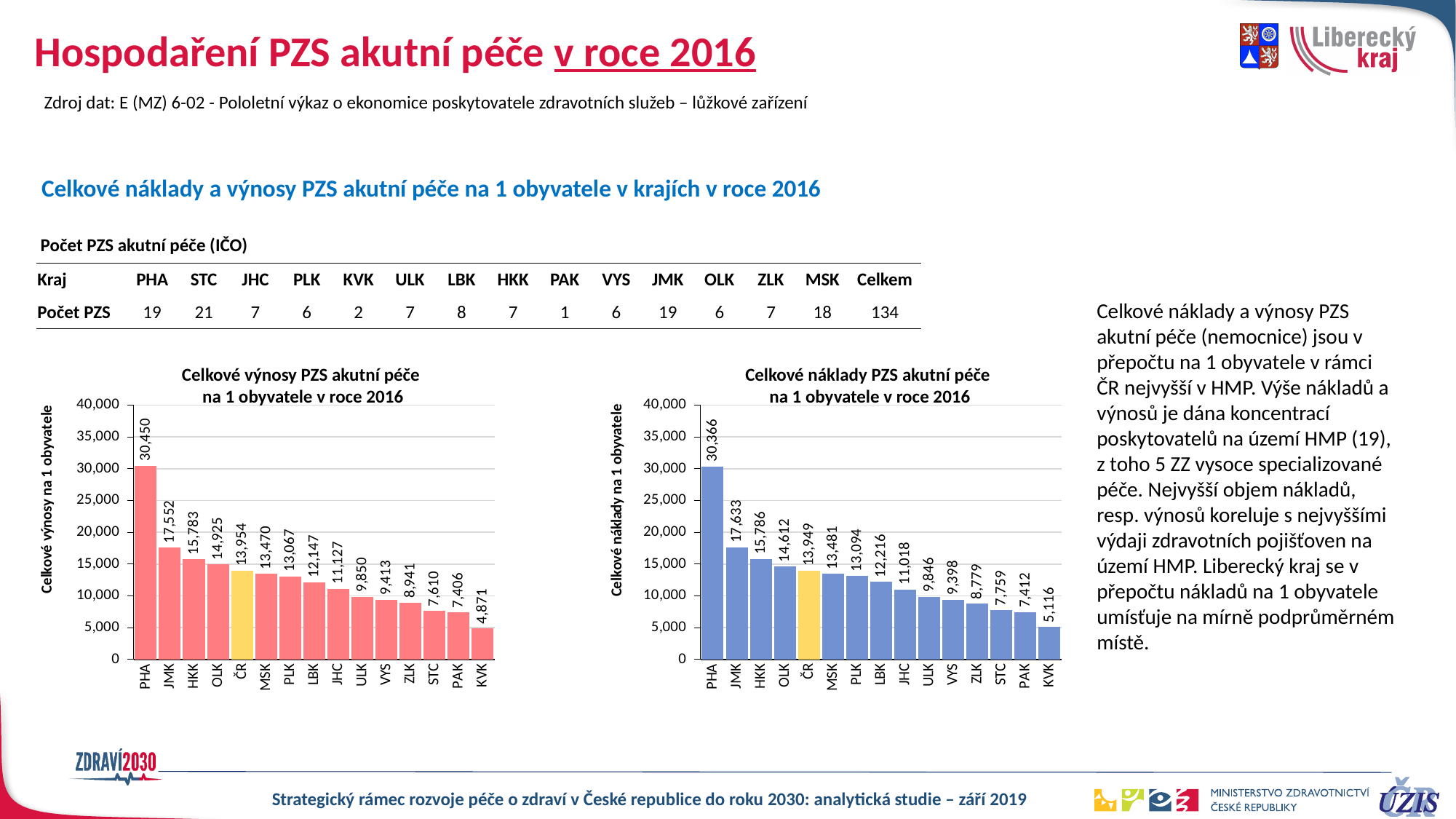
In the chart 'Celkové náklady PZS akutní péče na 1 obyvatele v roce 2016', what is the value for ČR? 13,949 In the chart 'Celkové výnosy PZS akutní péče na 1 obyvatele v roce 2016', which is larger, the value for HKK or the value for OLK? HKK How many categories are shown on the x axis of the chart 'Celkové výnosy PZS akutní péče na 1 obyvatele v roce 2016'? 15 In the chart 'Celkové náklady PZS akutní péče na 1 obyvatele v roce 2016', is the value for JHC greater or less than 10,000? greater In the chart 'Celkové výnosy PZS akutní péče na 1 obyvatele v roce 2016', which category has the highest value? PHA In the chart 'Celkové výnosy PZS akutní péče na 1 obyvatele v roce 2016', do the values rise or fall from left to right along the x axis? fall What kind of chart is 'Celkové náklady PZS akutní péče na 1 obyvatele v roce 2016'? bar chart In the chart 'Celkové náklady PZS akutní péče na 1 obyvatele v roce 2016', which bar is coloured differently (yellow) from the others? ČR In the chart 'Celkové náklady PZS akutní péče na 1 obyvatele v roce 2016', which category has the lowest value? KVK In the chart 'Celkové výnosy PZS akutní péče na 1 obyvatele v roce 2016', what is the value for LBK? 12,147 In the chart 'Celkové výnosy PZS akutní péče na 1 obyvatele v roce 2016', what is the difference between the values for PHA and JMK? 12,898 In the chart 'Celkové náklady PZS akutní péče na 1 obyvatele v roce 2016', what is the difference between the values for LBK and KVK? 7,100